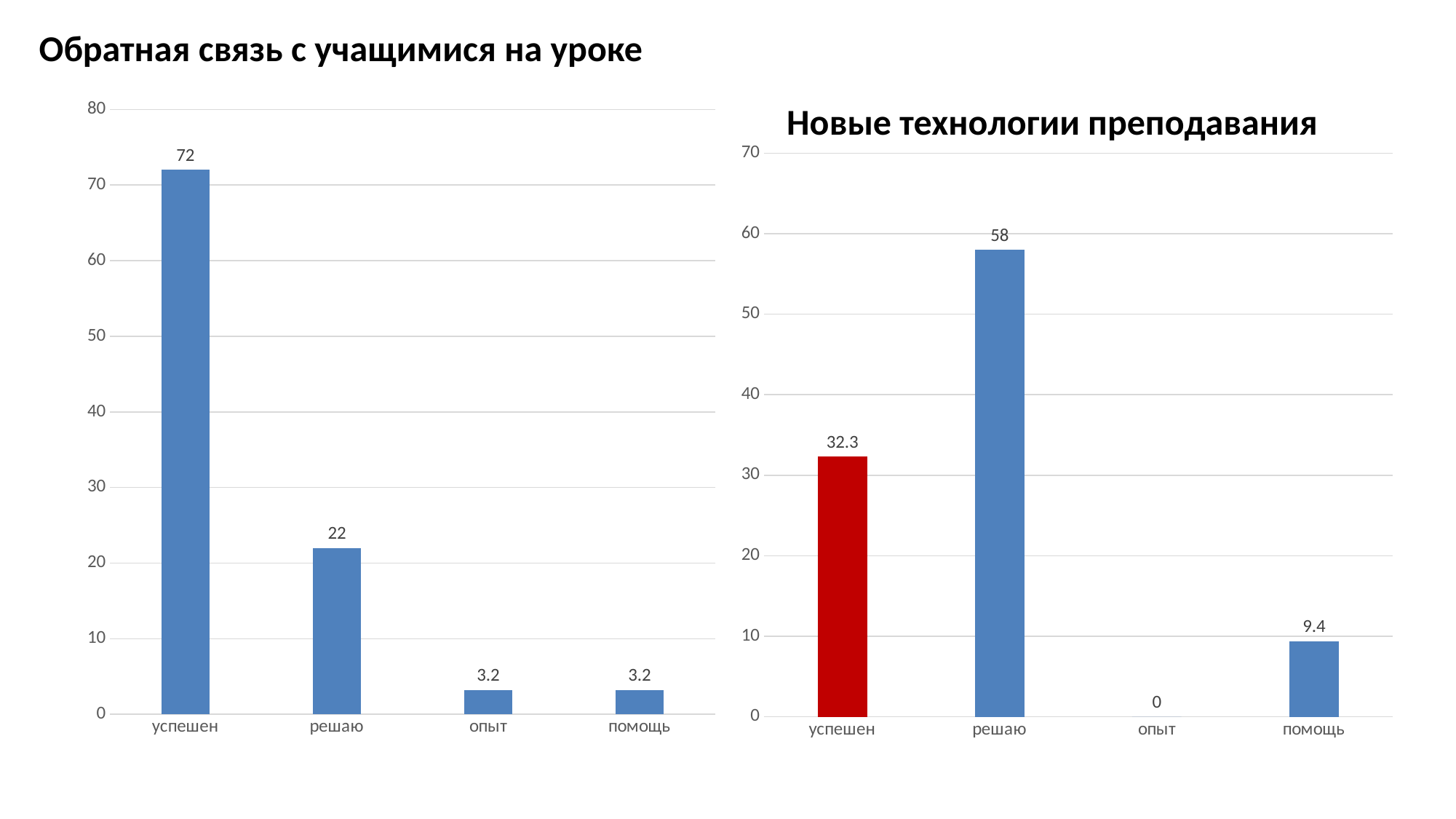
In the chart titled 'Новые технологии преподавания', which category has the lowest value? опыт In the chart titled 'Новые технологии преподавания', which is larger, the value for 'успешен' or the value for 'решаю'? решаю In the chart titled 'Новые технологии преподавания', what is the difference between the values for 'решаю' and 'успешен'? 25.7 In the chart titled 'Новые технологии преподавания', which category has the highest value? решаю In the chart titled 'Новые технологии преподавания', what is the value for 'помощь'? 9.4 In the chart titled 'Новые технологии преподавания', what is the value for 'успешен'? 32.3 In the chart titled 'Обратная связь с учащимися на уроке', what is the difference between the values for 'успешен' and 'решаю'? 50 In the chart titled 'Новые технологии преподавания', which bar is coloured red? успешен In the chart titled 'Обратная связь с учащимися на уроке', how many categories are shown on the x axis? 4 In the chart titled 'Обратная связь с учащимися на уроке', which category has the highest value? успешен In the chart titled 'Обратная связь с учащимися на уроке', what is the value for 'успешен'? 72 In the chart titled 'Обратная связь с учащимися на уроке', what is the value for 'решаю'? 22